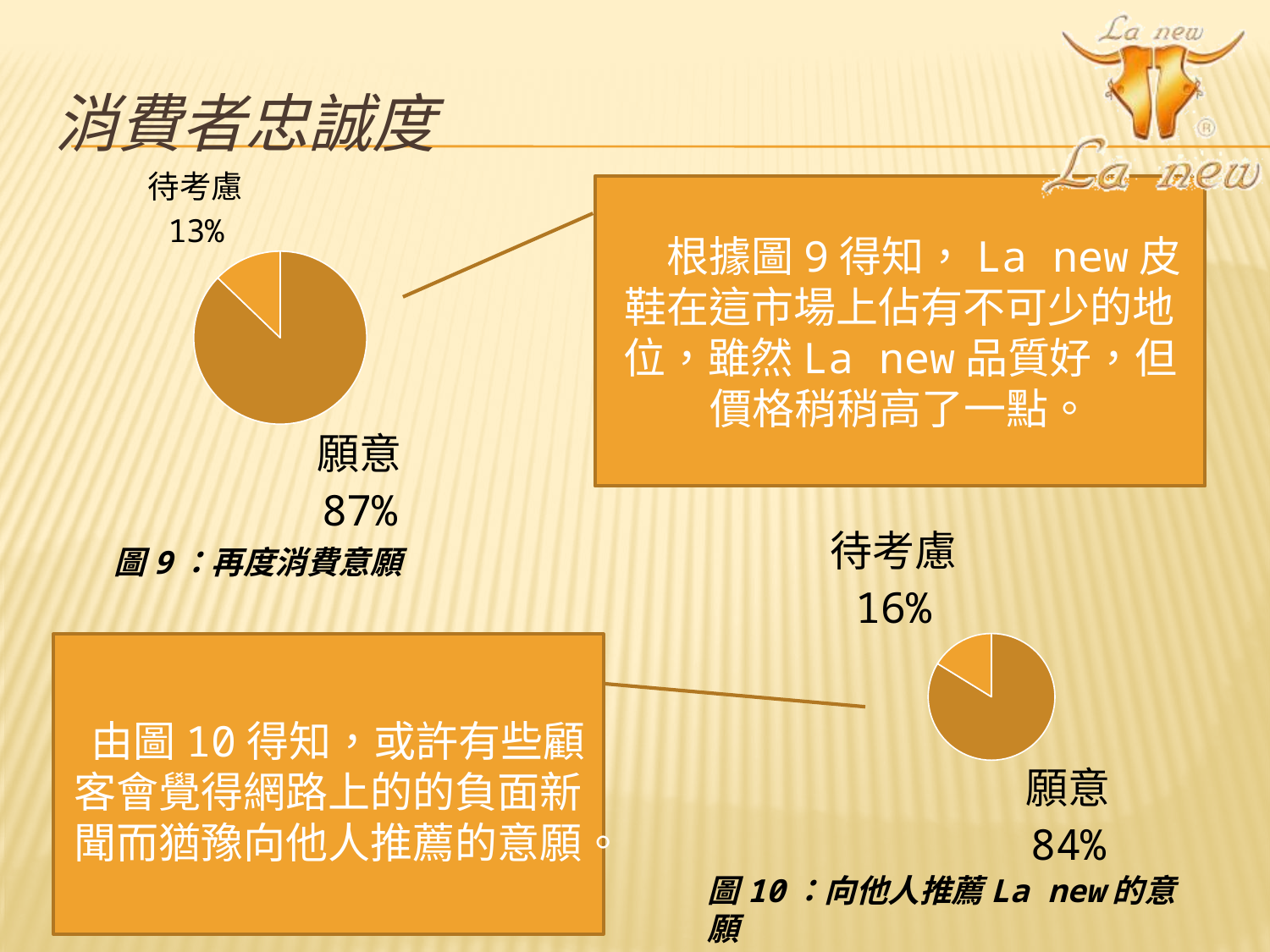
In the chart 圖 10：向他人推薦 La new 的意願 (bottom right), what percentage is labelled 待考慮? 16% In the chart 圖 9：再度消費意願 (top left), what percentage is labelled 待考慮? 13% Which chart has the larger 待考慮 share: 圖 9 (top left) or 圖 10 (bottom right)? 圖 10 In the chart 圖 10：向他人推薦 La new 的意願 (bottom right), what percentage is labelled 願意? 84% In the chart 圖 10：向他人推薦 La new 的意願 (bottom right), which slice is the smallest? 待考慮 What is the caption of the chart in the top left of the slide? 圖 9：再度消費意願 In the chart 圖 9：再度消費意願 (top left), what percentage is labelled 願意? 87% In the chart 圖 9：再度消費意願 (top left), which slice is the largest? 願意 What type of chart is 圖 10：向他人推薦 La new 的意願 (bottom right)? Pie chart How many slices does the chart 圖 9：再度消費意願 (top left) have? 2 In the chart 圖 9：再度消費意願 (top left), what is the difference in percentage points between 願意 and 待考慮? 74 In the chart 圖 10：向他人推薦 La new 的意願 (bottom right), what is the difference in percentage points between 願意 and 待考慮? 68